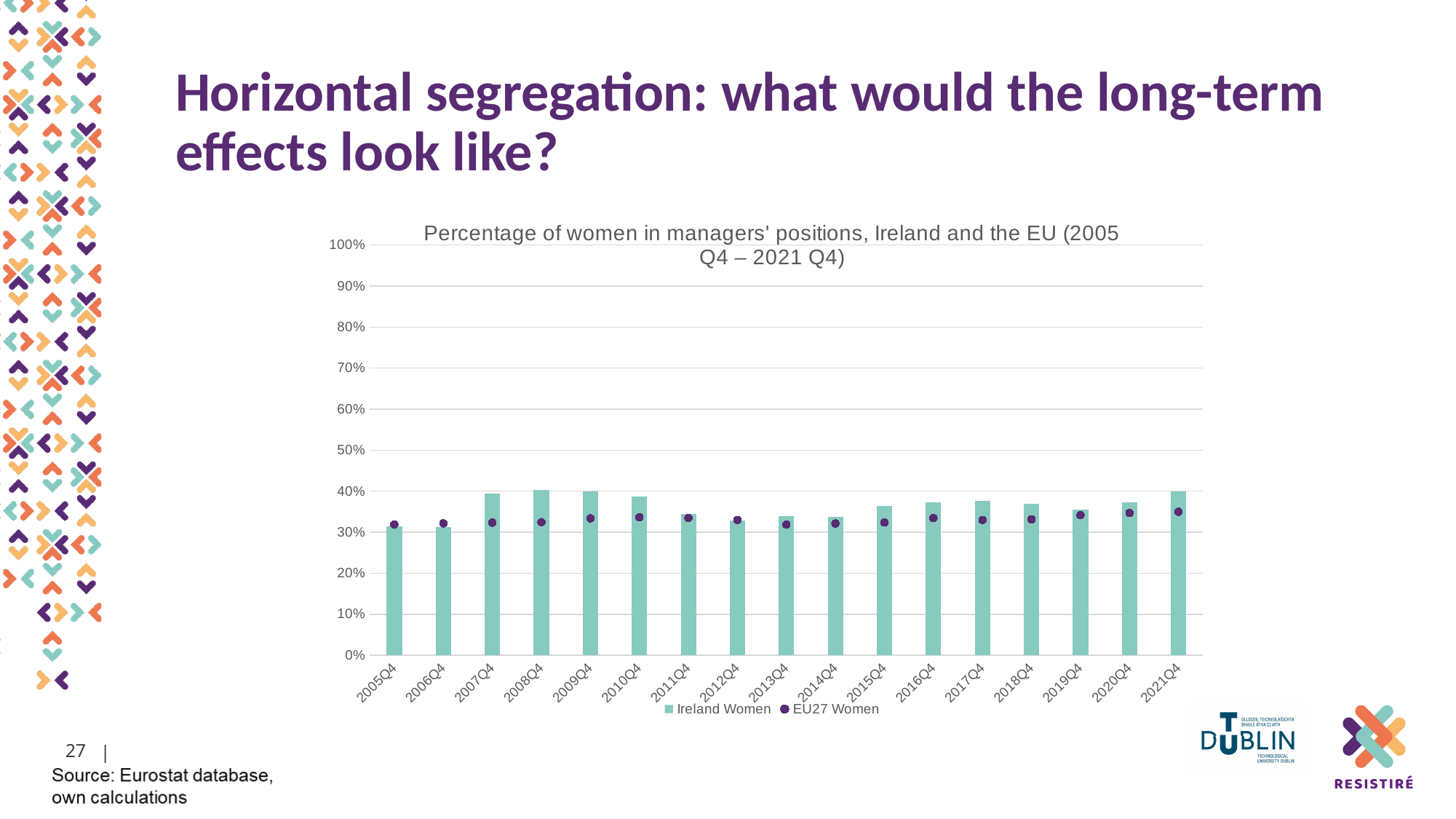
Is the value for EU27 Women in 2021Q4 greater or less than 30%? greater How many series does the legend list? 2 Is the value for Ireland Women in 2009Q4 greater or less than 35%? greater Is the value for EU27 Women in 2005Q4 greater or less than 40%? less What kind of chart is shown on the slide? Bar chart (with a dot series overlaid) How many quarters (categories) are plotted along the x axis? 17 Do the EU27 Women values generally rise or fall from 2005Q4 to 2021Q4? rise What is the title of the chart? Percentage of women in managers' positions, Ireland and the EU (2005 Q4 – 2021 Q4) Which is larger for Ireland Women: the value in 2008Q4 or the value in 2012Q4? 2008Q4 Which series is shown as purple dots? EU27 Women In 2021Q4, which series has the higher value: Ireland Women or EU27 Women? Ireland Women